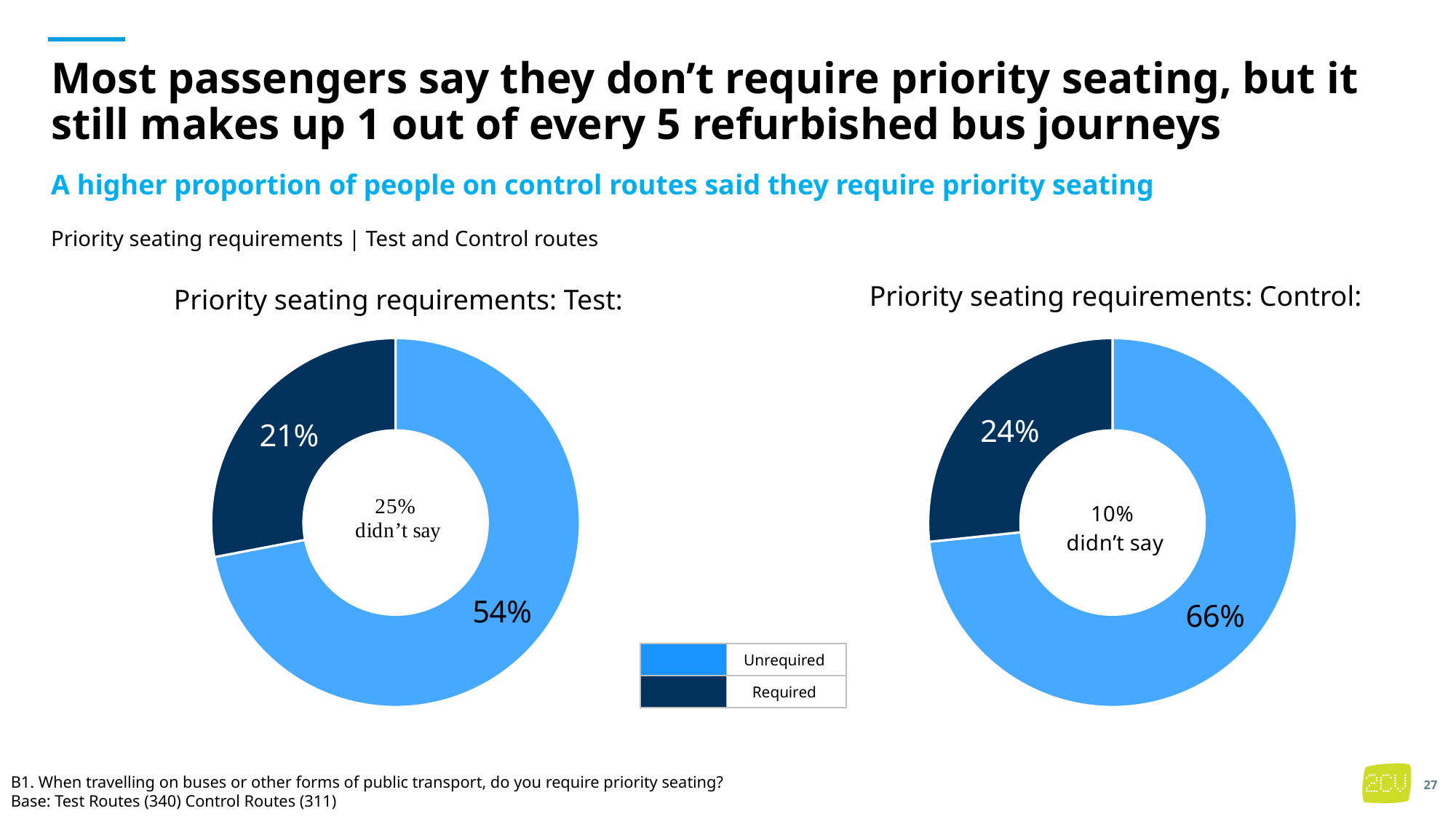
What type of chart is used on this slide? Doughnut chart In the 'Priority seating requirements: Control' chart, what percentage is shown for Required? 24% In the 'Priority seating requirements: Control' chart, what percentage didn't say, according to the centre label? 10% In the 'Priority seating requirements: Control' chart, what percentage is shown for Unrequired? 66% In the 'Priority seating requirements: Test' chart, what percentage is shown for Required? 21% In the 'Priority seating requirements: Test' chart, what percentage is shown for Unrequired? 54% How many entries does the legend list? 2 What is the difference between the Unrequired percentage in the Control chart and the Unrequired percentage in the Test chart? 12 percentage points In the 'Priority seating requirements: Test' chart, what percentage didn't say, according to the centre label? 25% Which chart shows a higher Required percentage, the Test chart or the Control chart? Control In the 'Priority seating requirements: Test' chart, which category has the largest share? Unrequired In the 'Priority seating requirements: Control' chart, which labelled category has the smallest share? Required